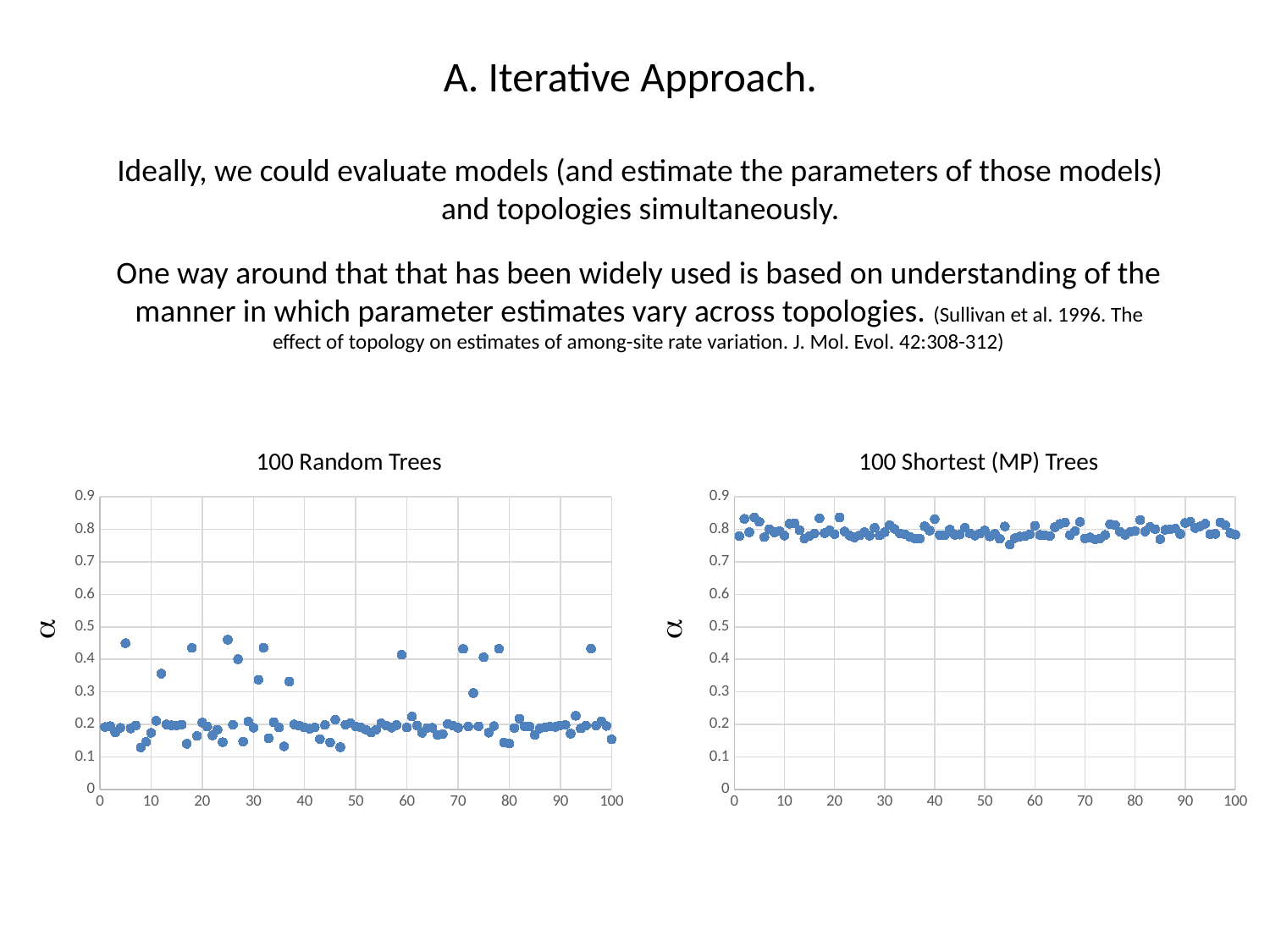
What is the title of the chart on the left of the slide? 100 Random Trees In the '100 Random Trees' chart, is the value at x = 25 greater or less than 0.4? greater What is the highest tick value shown on the y axis of the '100 Random Trees' chart? 0.9 In the '100 Shortest (MP) Trees' chart, are the plotted values greater or less than 0.7? greater In the '100 Random Trees' chart, is the value at x = 5 greater or less than 0.3? greater What kind of chart is the '100 Random Trees' chart? scatter chart What is the title of the chart on the right of the slide? 100 Shortest (MP) Trees In the '100 Shortest (MP) Trees' chart, do the α values show a clear rising or falling trend along the x axis, or stay roughly flat? roughly flat What kind of chart is the '100 Shortest (MP) Trees' chart? scatter chart Which chart shows higher α values overall, '100 Random Trees' or '100 Shortest (MP) Trees'? 100 Shortest (MP) Trees